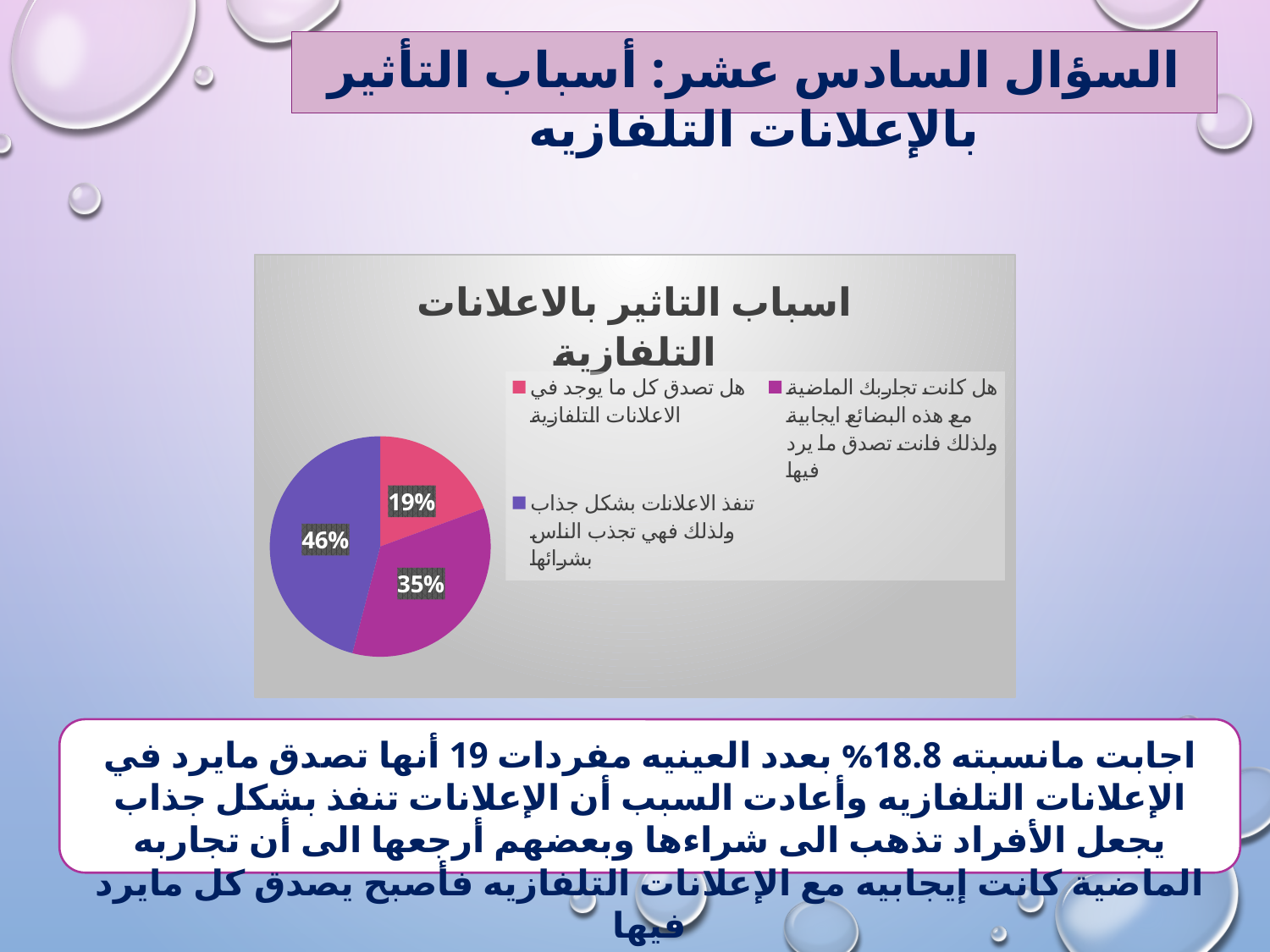
What percentage is shown for the slice 'هل تصدق كل ما يوجد في الاعلانات التلفازية'? 19% How many slices does the pie chart have? 3 How many entries does the chart legend list? 3 What is the difference in percentage points between the largest slice (46%) and the smallest slice (19%)? 27 Which category has the largest share of the pie? تنفذ الاعلانات بشكل جذاب ولذلك فهي تجذب الناس بشرائها Which is larger: the slice for 'هل كانت تجاربك الماضية مع هذه البضائع ايجابية ولذلك فانت تصدق ما يرد فيها' or the slice for 'هل تصدق كل ما يوجد في الاعلانات التلفازية'? هل كانت تجاربك الماضية مع هذه البضائع ايجابية ولذلك فانت تصدق ما يرد فيها What percentage is shown for the slice 'هل كانت تجاربك الماضية مع هذه البضائع ايجابية ولذلك فانت تصدق ما يرد فيها'? 35% What percentage is shown for the slice 'تنفذ الاعلانات بشكل جذاب ولذلك فهي تجذب الناس بشرائها'? 46% Which category has the smallest share of the pie? هل تصدق كل ما يوجد في الاعلانات التلفازية What type of chart is shown on the slide? pie chart What is the title of the chart? اسباب التاثير بالاعلانات التلفازية What colour is the slice labelled 46%? purple